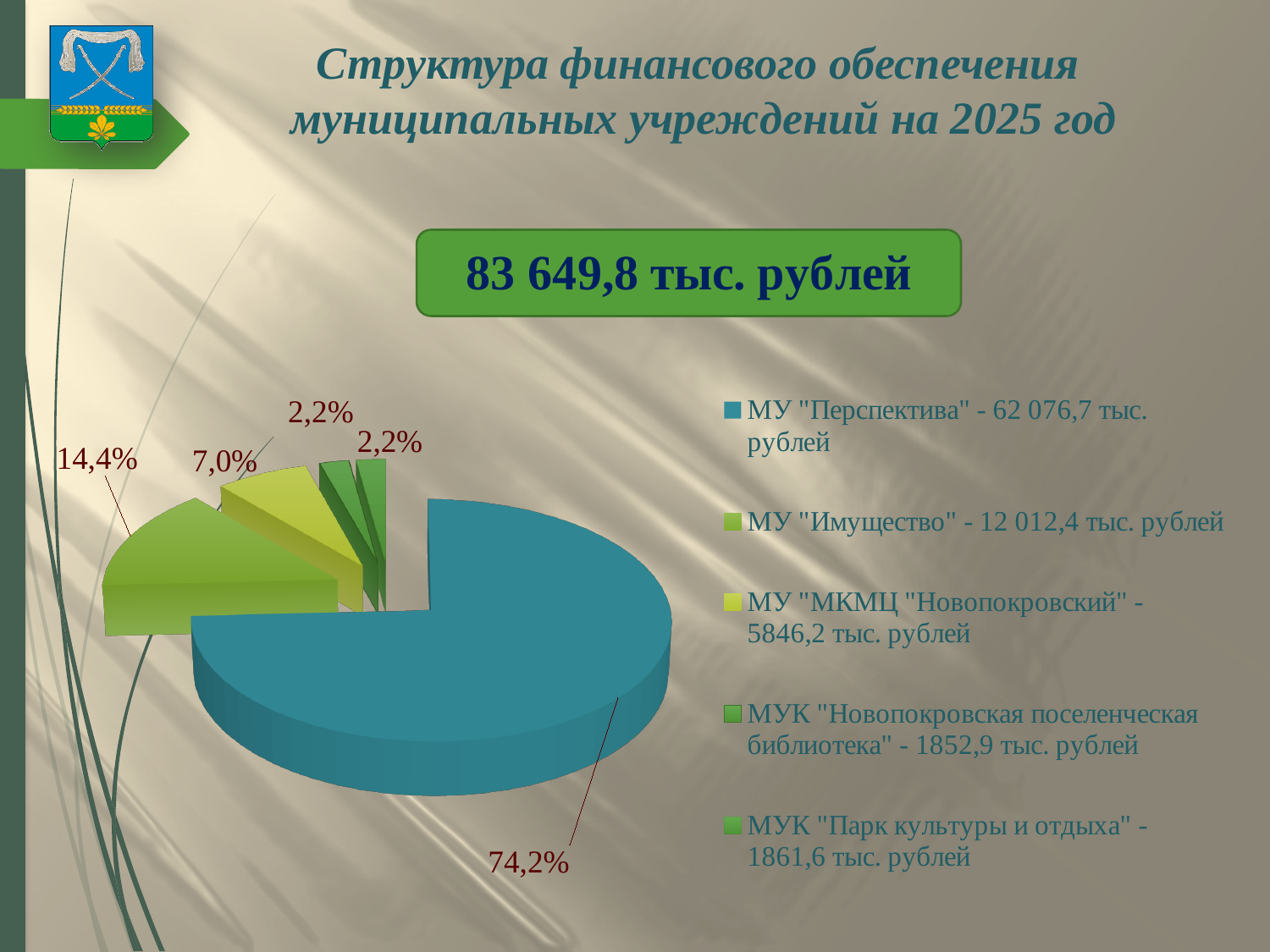
Which is larger, the share for МУ "Имущество" or the share for МУ "МКМЦ "Новопокровский""? МУ "Имущество" What share of the pie does МУ "Перспектива" account for? 74,2% How many entries does the legend of the pie chart list? 5 What share of the pie does МУ "Имущество" account for? 14,4% Which institution has the largest slice of the pie? МУ "Перспектива" How many slices does the pie chart have? 5 What amount in thousand rubles is listed in the legend for МУК "Новопокровская поселенческая библиотека"? 1852,9 тыс. рублей What share of the pie does МУ "МКМЦ "Новопокровский"" account for? 7,0% What is the difference in percentage points between the share of МУ "Перспектива" and the share of МУ "Имущество"? 59,8 What amount in thousand rubles is listed in the legend for МУ "Имущество"? 12 012,4 тыс. рублей What kind of chart is shown on the slide? pie chart